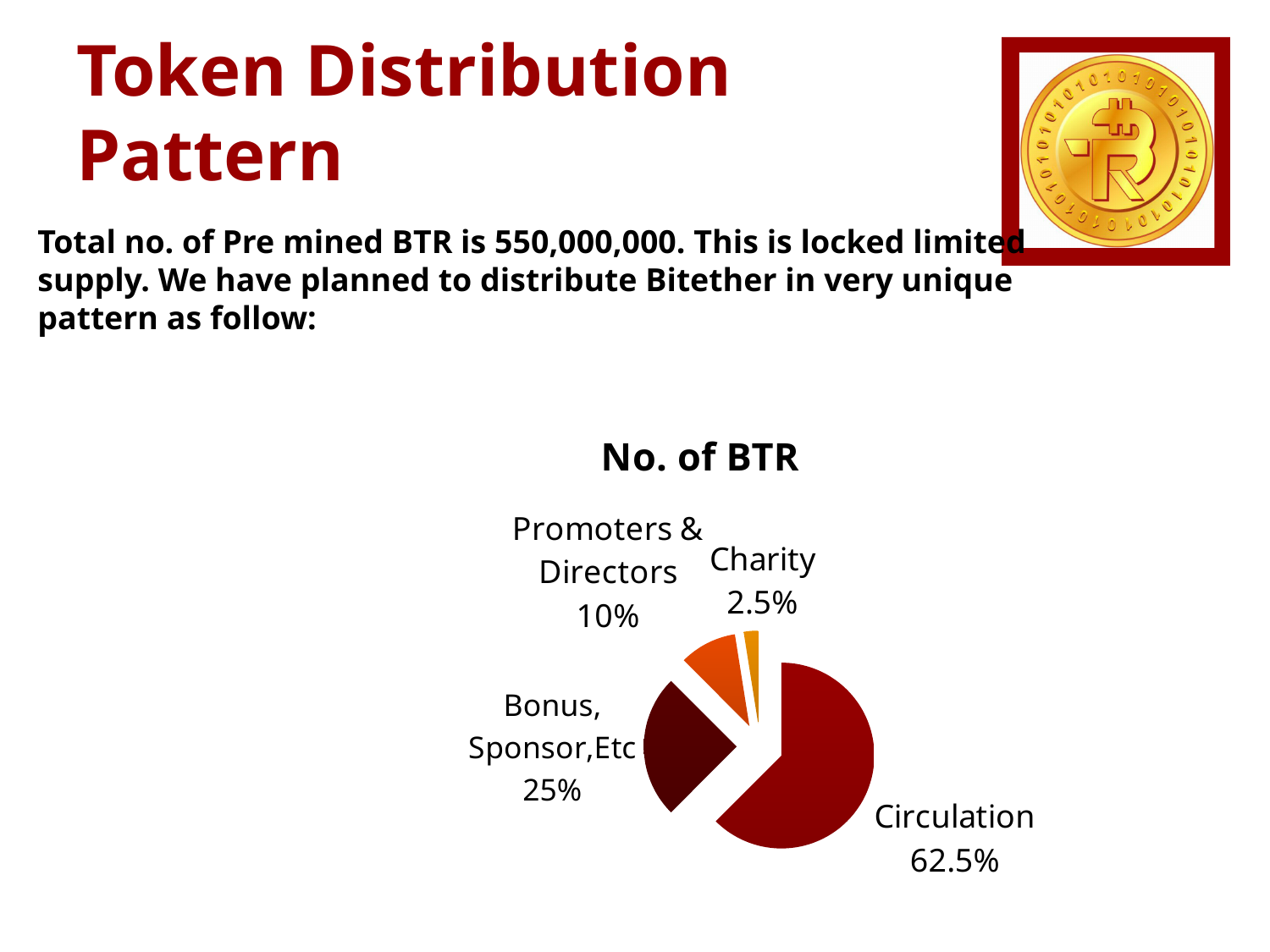
What share of the pie does Charity represent? 2.5% What is the difference in percentage points between the Promoters & Directors share and the Charity share? 7.5% What share of the pie does Promoters & Directors represent? 10% What type of chart is shown on the slide? pie chart What share of the pie does Bonus, Sponsor,Etc represent? 25% Which category has the largest slice of the pie? Circulation How many slices does the pie chart have? 4 What is the title of the chart? No. of BTR What is the difference in percentage points between the Circulation share and the Bonus, Sponsor,Etc share? 37.5% Which is larger, the share for Bonus, Sponsor,Etc or the share for Promoters & Directors? Bonus, Sponsor,Etc Which category has the smallest slice of the pie? Charity